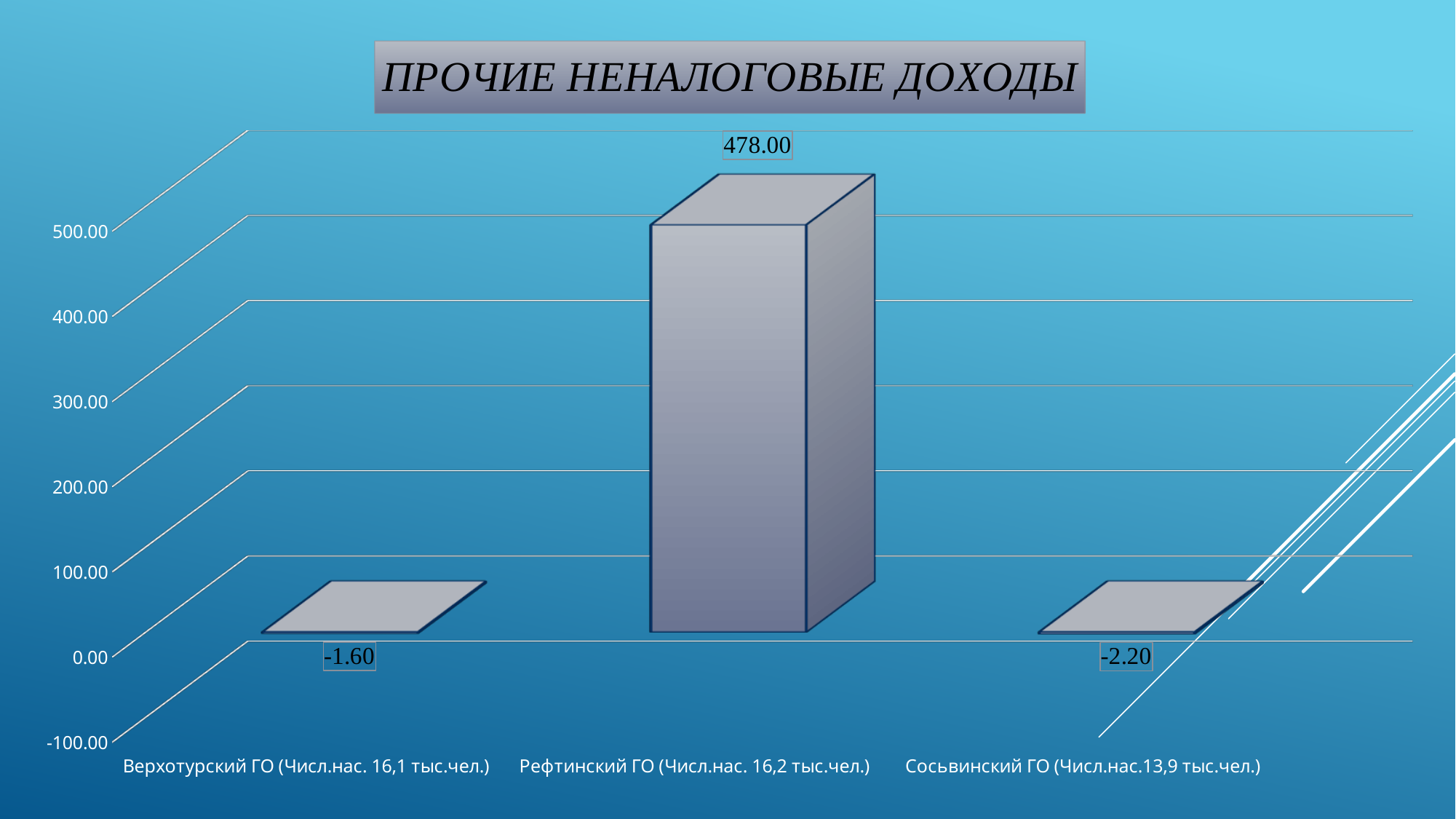
What is the value for Рефтинский ГО (Числ.нас. 16,2 тыс.чел.)? 478.00 Which category has the highest value? Рефтинский ГО (Числ.нас. 16,2 тыс.чел.) What kind of chart is shown on the slide? bar chart What is the value for Верхотурский ГО (Числ.нас. 16,1 тыс.чел.)? -1.60 What is the difference between the values for Рефтинский ГО and Верхотурский ГО? 479.60 What is the title of the chart? ПРОЧИЕ НЕНАЛОГОВЫЕ ДОХОДЫ What is the difference between the values for Верхотурский ГО and Сосьвинский ГО? 0.60 Which category has the lowest value? Сосьвинский ГО (Числ.нас.13,9 тыс.чел.) Is the value for Рефтинский ГО greater or less than 400.00? greater Which is larger, the value for Верхотурский ГО or the value for Сосьвинский ГО? Верхотурский ГО How many categories are shown on the chart? 3 What is the value for Сосьвинский ГО (Числ.нас.13,9 тыс.чел.)? -2.20